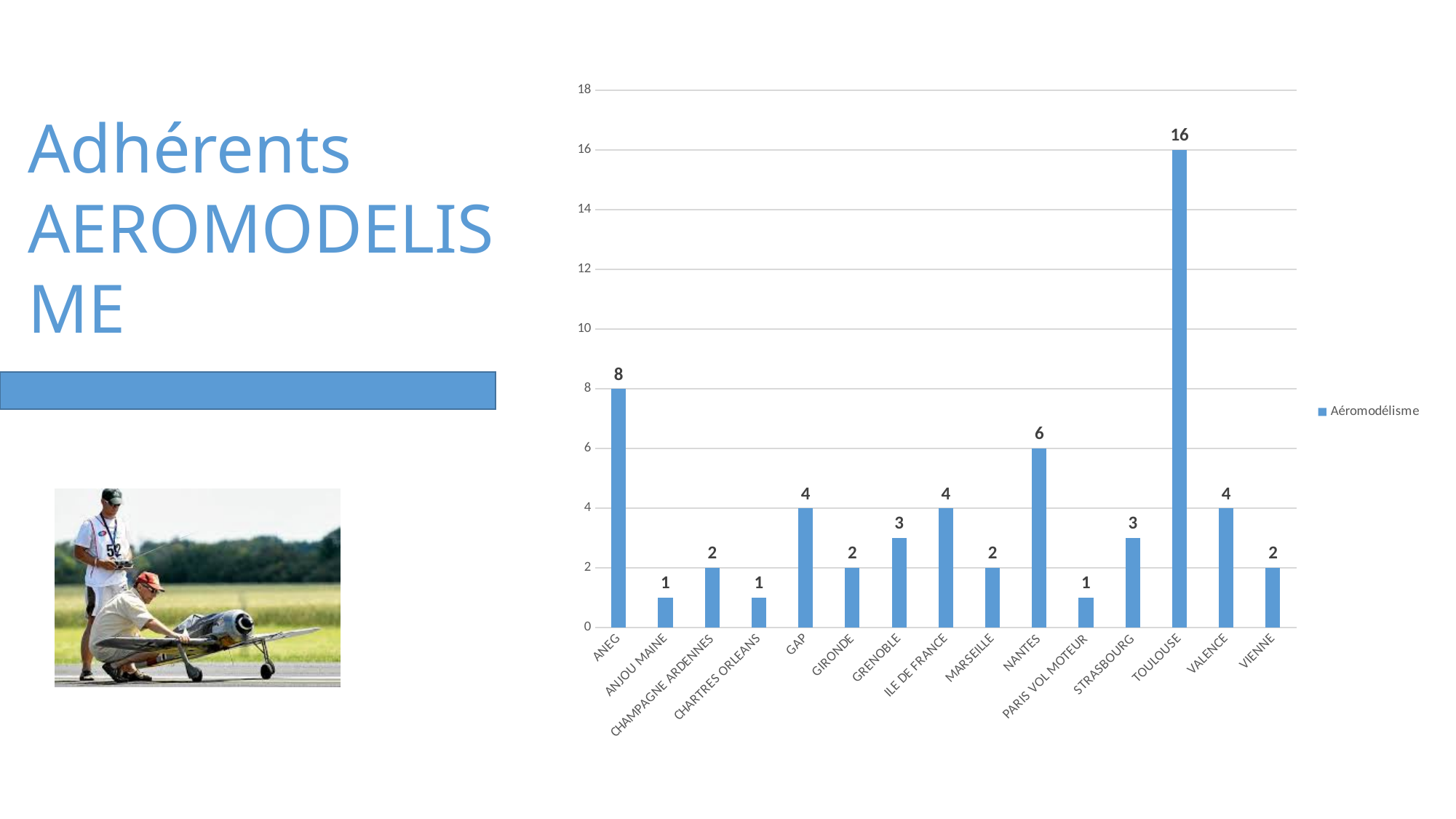
Which category has the highest value? TOULOUSE What is the value for NANTES? 6 What is the value for TOULOUSE? 16 What is the difference between the values for NANTES and STRASBOURG? 3 What is the value for GRENOBLE? 3 What is the difference between the values for TOULOUSE and ANEG? 8 Which is larger, the value for GAP or the value for GIRONDE? GAP Is the value for TOULOUSE greater or less than 10? greater What is the value for ANEG? 8 How many series does the legend list? 1 How many categories are shown on the x axis? 15 What kind of chart is shown on the slide? bar chart